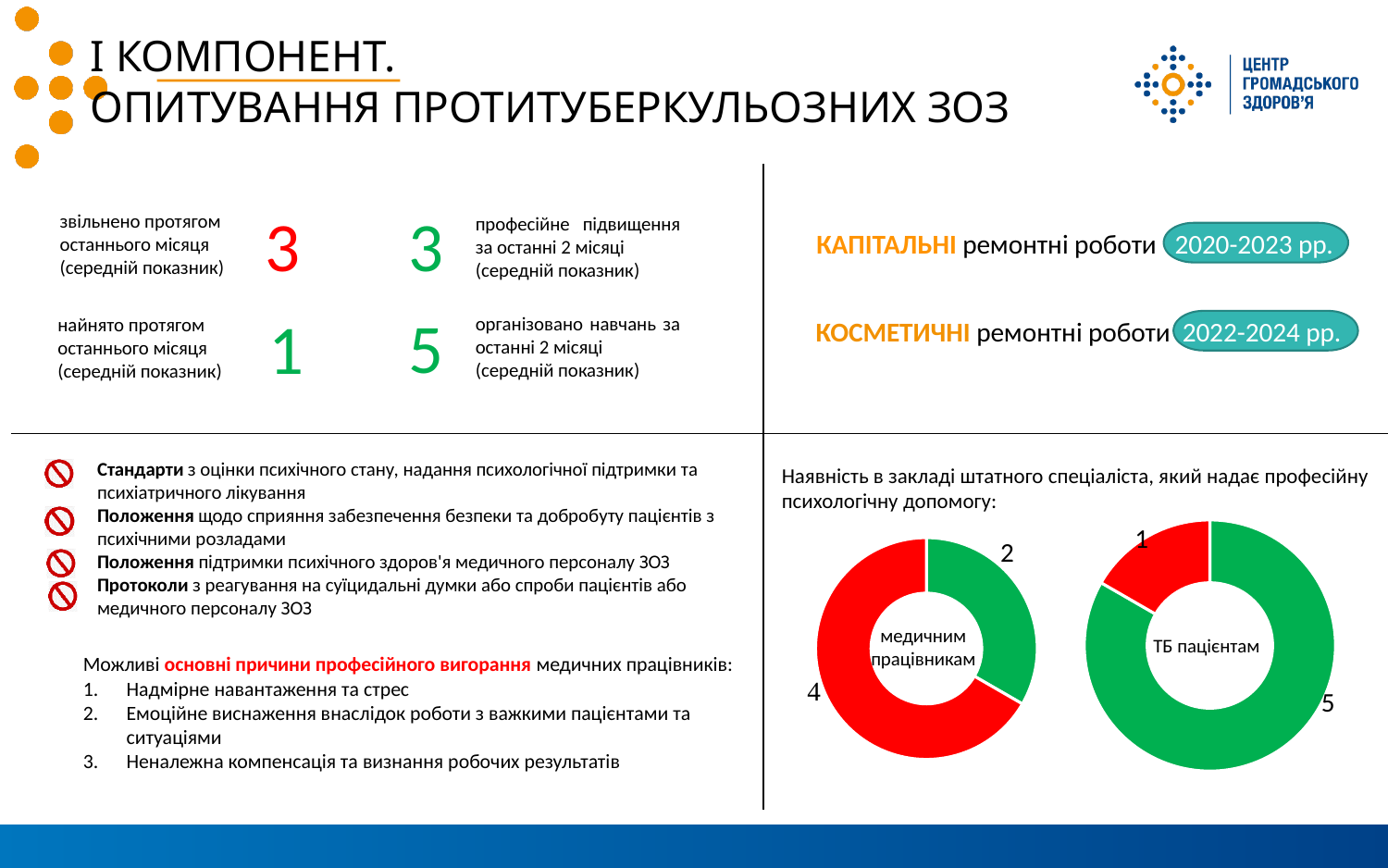
How many segments does the left donut chart ('медичним працівникам') have? 2 In the right donut chart ('ТБ пацієнтам'), what is the difference between the green and red segment values? 4 What is the total of the two segments in the right donut chart ('ТБ пацієнтам')? 6 In the left donut chart ('медичним працівникам'), what is the difference between the red and green segment values? 2 In the left donut chart ('медичним працівникам'), which segment is larger, the green or the red one? Red In the right donut chart ('ТБ пацієнтам'), which segment is the smallest? Red (1) In the left donut chart labelled 'медичним працівникам', what value does the green segment show? 2 In the left donut chart labelled 'медичним працівникам', what value does the red segment show? 4 In the right donut chart labelled 'ТБ пацієнтам', what value does the red segment show? 1 In the right donut chart labelled 'ТБ пацієнтам', what value does the green segment show? 5 What kind of chart is used to show the availability of a staff psychological specialist for medical workers? Donut (pie) chart How many donut charts are shown on the slide? 2